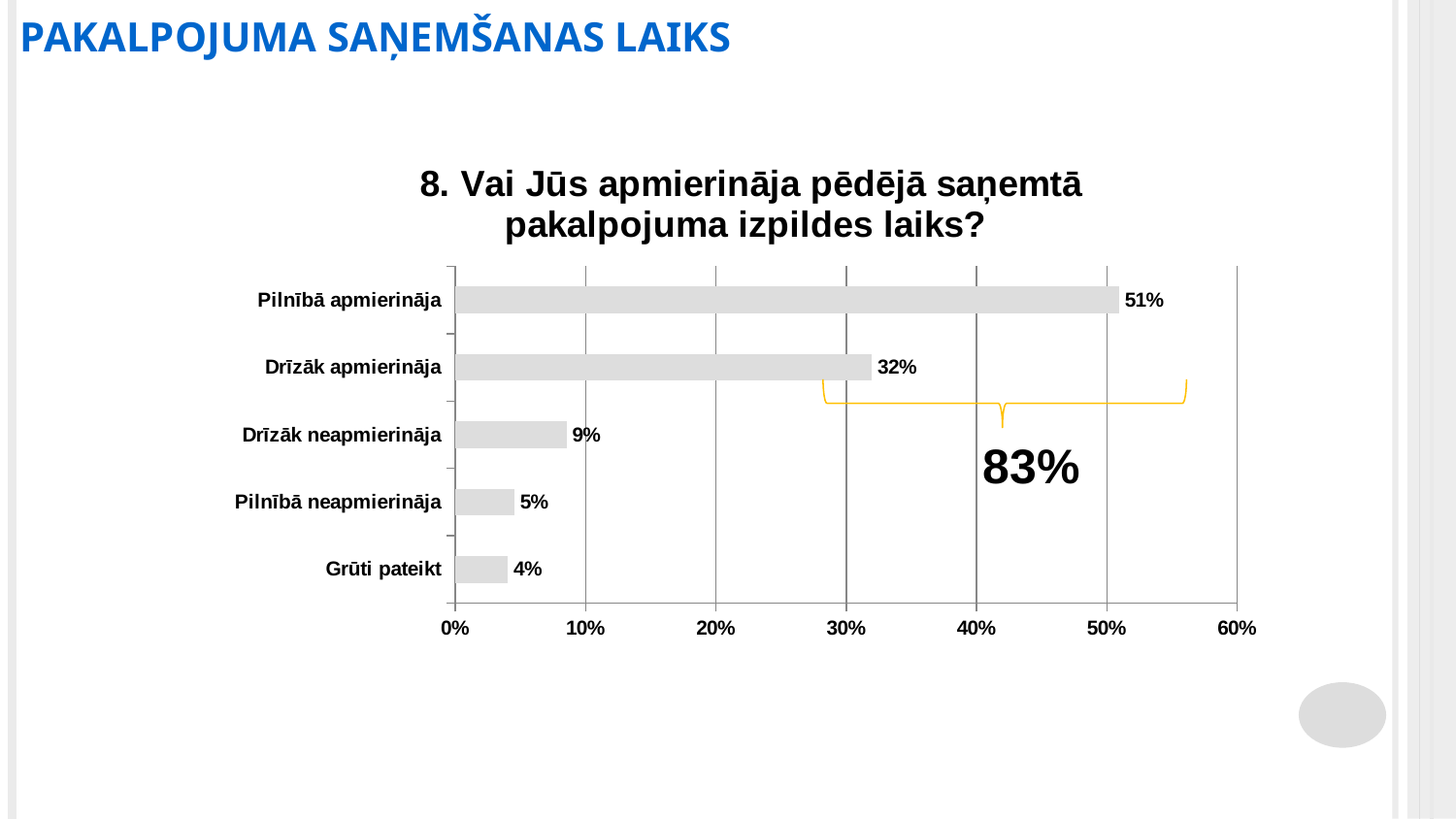
What kind of chart is shown on the slide? bar chart What is the value for "Drīzāk apmierināja"? 32% Which category has the highest value? Pilnībā apmierināja How many categories are shown in the chart? 5 Which is larger, the value for "Drīzāk neapmierināja" or "Pilnībā neapmierināja"? Drīzāk neapmierināja What is the value for "Pilnībā apmierināja"? 51% What is the value for "Grūti pateikt"? 4% What is the value for "Drīzāk neapmierināja"? 9% What combined percentage is highlighted by the bracket on the chart? 83% Is the value for "Pilnībā apmierināja" greater or less than 40%? greater What is the difference between the values for "Pilnībā apmierināja" and "Drīzāk apmierināja"? 19% Which category has the lowest value? Grūti pateikt